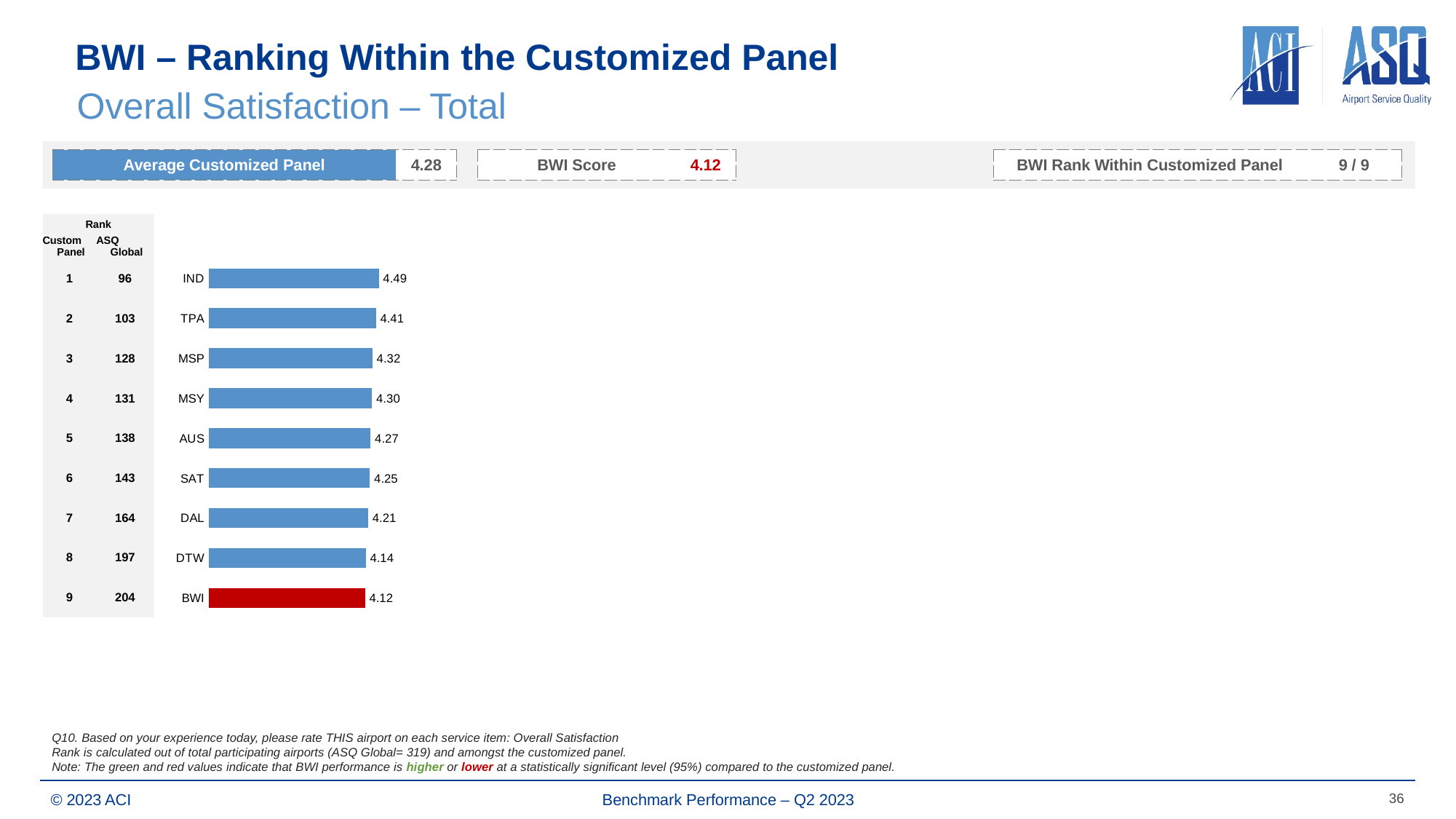
What is the difference between the scores of IND and BWI? 0.37 What is the difference between the scores of TPA and MSP? 0.09 Which has a higher score, DAL or DTW? DAL What is the Average Customized Panel score shown on the slide? 4.28 Which airport has the highest Overall Satisfaction score? IND What is the Overall Satisfaction score for AUS? 4.27 What is the Overall Satisfaction score for IND? 4.49 How many airports are shown in the chart? 9 Which airport's bar is coloured red? BWI What is the Overall Satisfaction score for BWI? 4.12 Which airport has the lowest Overall Satisfaction score? BWI What kind of chart is shown on the slide? Bar chart